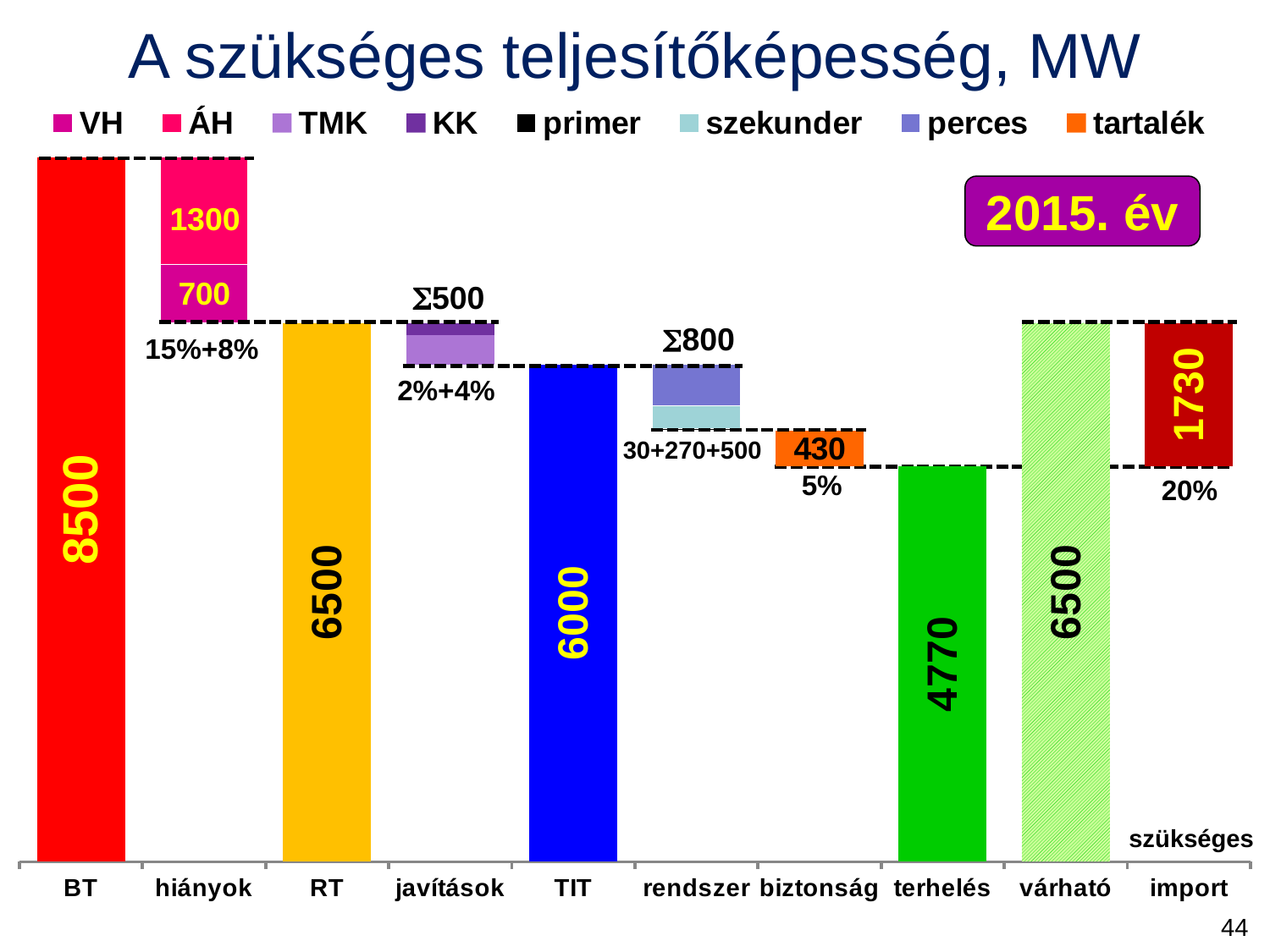
What is the difference between the BT value and the RT value? 2000 What value is labelled on the terhelés bar? 4770 Which category has the tallest bar? BT Which is larger, the RT bar or the TIT bar? RT What value is labelled on the biztonság bar? 430 What is the title of the chart? A szükséges teljesítőképesség, MW What kind of chart is shown on the slide? bar chart How many categories are shown on the x axis? 10 What is the total of the two segments in the hiányok bar (1300 and 700)? 2000 How many entries does the legend list? 8 What value is labelled on the BT bar? 8500 What value is labelled on the import bar? 1730